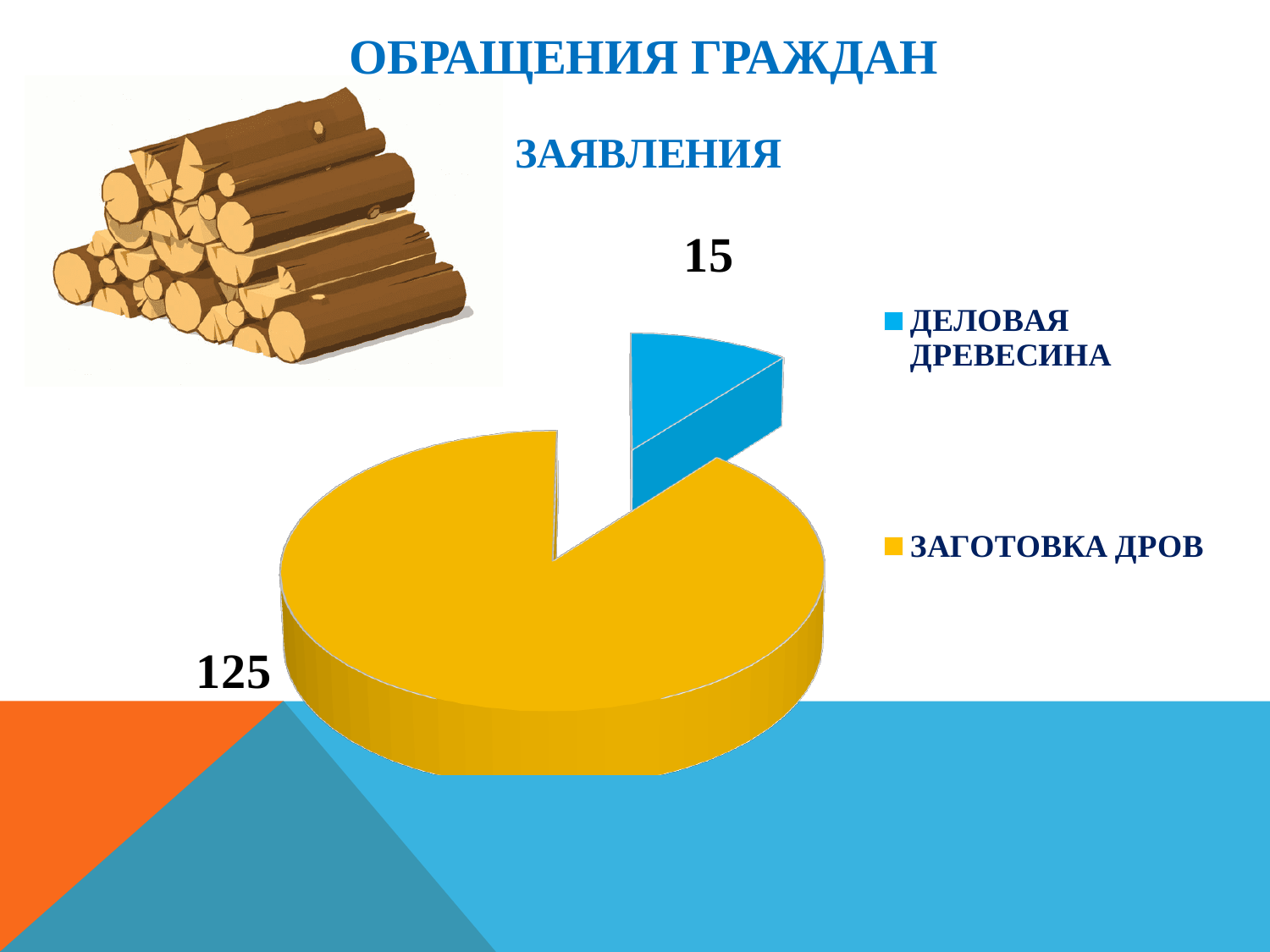
What is the title of the chart? ЗАЯВЛЕНИЯ What is the value for ДЕЛОВАЯ ДРЕВЕСИНА? 15 Which is larger, ДЕЛОВАЯ ДРЕВЕСИНА or ЗАГОТОВКА ДРОВ? ЗАГОТОВКА ДРОВ What colour is the slice for ДЕЛОВАЯ ДРЕВЕСИНА? blue Which category has the smallest slice? ДЕЛОВАЯ ДРЕВЕСИНА What is the difference between the values for ЗАГОТОВКА ДРОВ and ДЕЛОВАЯ ДРЕВЕСИНА? 110 How many categories does the pie chart have? 2 What type of chart is shown on the slide? pie chart Which category has the largest slice? ЗАГОТОВКА ДРОВ What is the total of all slices in the pie chart? 140 What is the value for ЗАГОТОВКА ДРОВ? 125